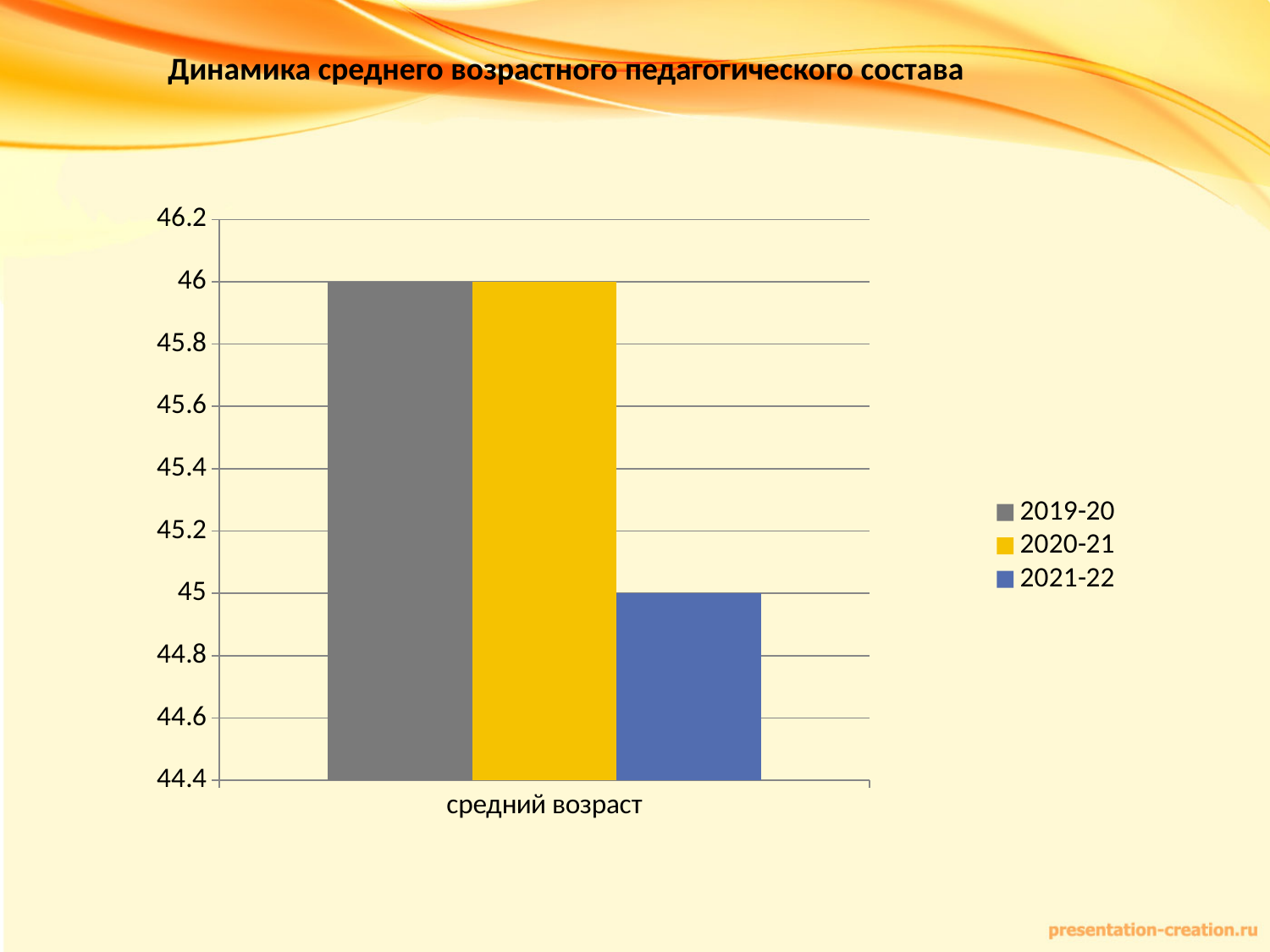
How many categories are shown on the x axis of the chart? 1 Which is larger, the value for 2019-20 or the value for 2021-22? 2019-20 How many series does the legend list? 3 What is the title of the slide? Динамика среднего возрастного педагогического состава Is the value for 2021-22 greater or less than 45.4? less Is the value for 2019-20 greater or less than 45.8? greater Which series has the lowest value in the chart? 2021-22 What is the value for the 2020-21 series in the chart? 46 What is the value for the 2019-20 series in the chart? 46 What kind of chart is shown on the slide? bar chart What is the value for the 2021-22 series in the chart? 45 What is the difference between the value for 2020-21 and the value for 2021-22? 1